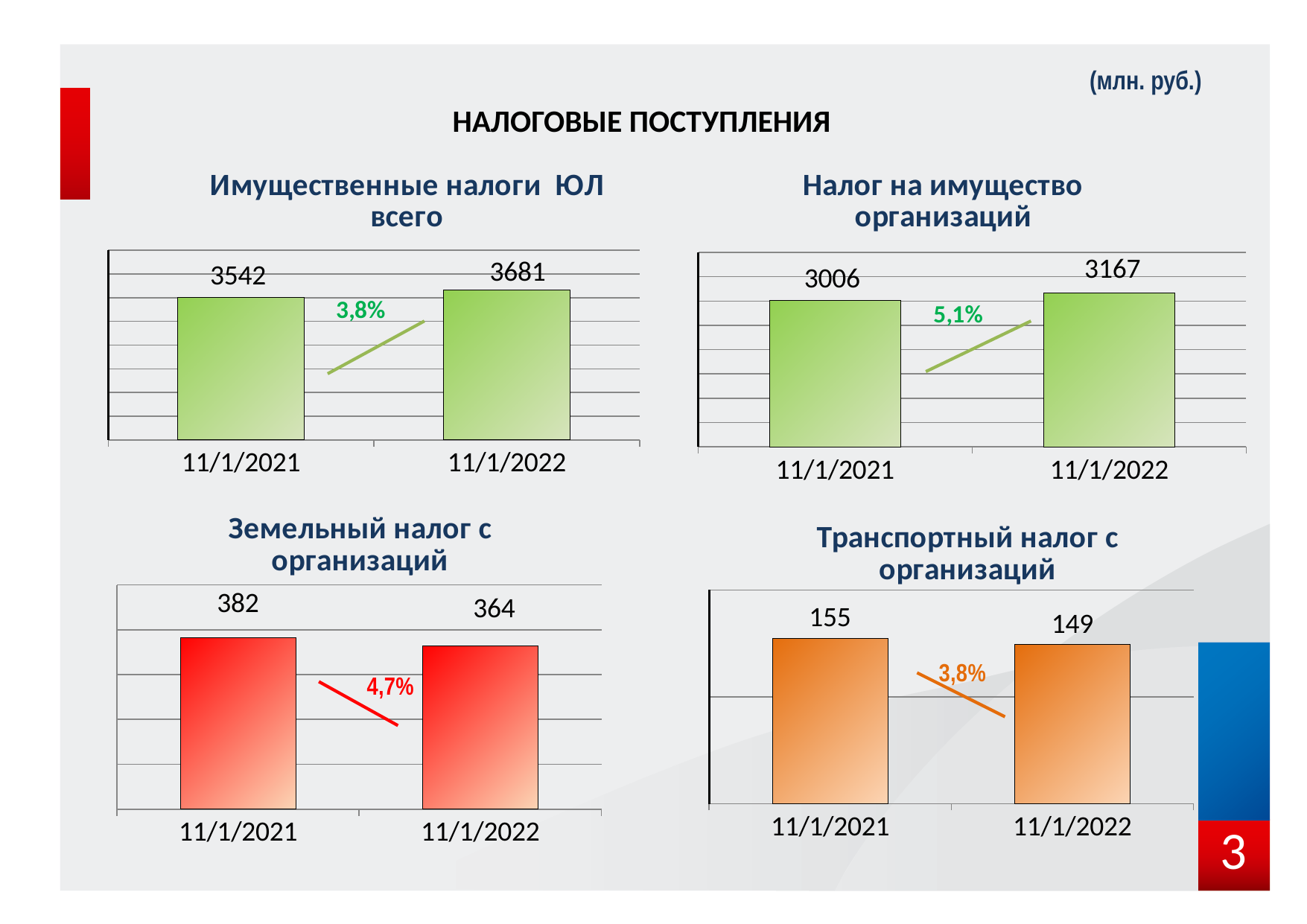
In the chart titled "Транспортный налог с организаций", what is the value for 11/1/2021? 155 In the chart titled "Налог на имущество организаций", which date has the higher value? 11/1/2022 In the chart titled "Имущественные налоги ЮЛ всего", what is the difference between the 11/1/2022 and 11/1/2021 values? 139 In the chart titled "Земельный налог с организаций", what is the difference between the 11/1/2021 and 11/1/2022 values? 18 What percentage change is annotated on the chart titled "Налог на имущество организаций"? 5,1% In the chart titled "Земельный налог с организаций", what is the value for 11/1/2022? 364 In the chart titled "Транспортный налог с организаций", do the values rise or fall from 11/1/2021 to 11/1/2022? fall In the chart titled "Земельный налог с организаций", which date has the lower value? 11/1/2022 How many bars are shown in the chart titled "Транспортный налог с организаций"? 2 In the chart titled "Имущественные налоги ЮЛ всего", what is the value for 11/1/2022? 3681 In the chart titled "Налог на имущество организаций", what is the value for 11/1/2021? 3006 What kind of chart is the chart titled "Налог на имущество организаций"? bar chart